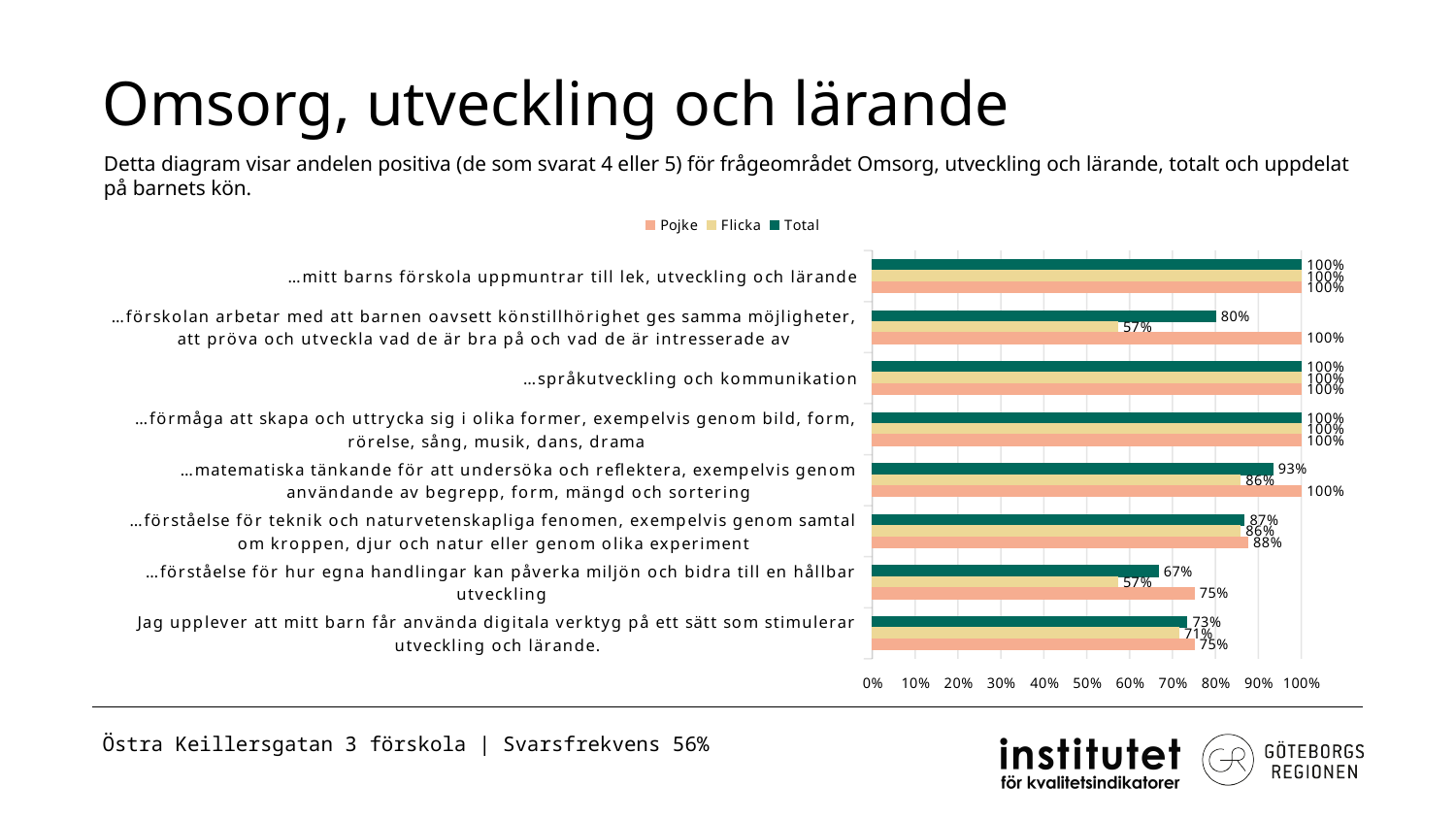
Which series is shown in dark green in the legend? Total What is the difference between the Pojke and Flicka values for "…förskolan arbetar med att barnen oavsett könstillhörighet ges samma möjligheter, att pröva och utveckla vad de är bra på och vad de är intresserade av"? 43% What is the Total value for "Jag upplever att mitt barn får använda digitala verktyg på ett sätt som stimulerar utveckling och lärande."? 73% What type of chart is shown on the slide? bar chart Which category has the lowest Total value? …förståelse för hur egna handlingar kan påverka miljön och bidra till en hållbar utveckling For "…förståelse för teknik och naturvetenskapliga fenomen, exempelvis genom samtal om kroppen, djur och natur eller genom olika experiment", which is larger: the Pojke value or the Flicka value? Pojke How many categories (statements) are plotted on the chart? 8 What is the Flicka value for "…matematiska tänkande för att undersöka och reflektera, exempelvis genom användande av begrepp, form, mängd och sortering"? 86% What is the Total value for "…förskolan arbetar med att barnen oavsett könstillhörighet ges samma möjligheter, att pröva och utveckla vad de är bra på och vad de är intresserade av"? 80% How many series does the legend list? 3 Is the Flicka value for "…förståelse för hur egna handlingar kan påverka miljön och bidra till en hållbar utveckling" greater or less than 60%? less What is the Pojke value for "…förståelse för hur egna handlingar kan påverka miljön och bidra till en hållbar utveckling"? 75%